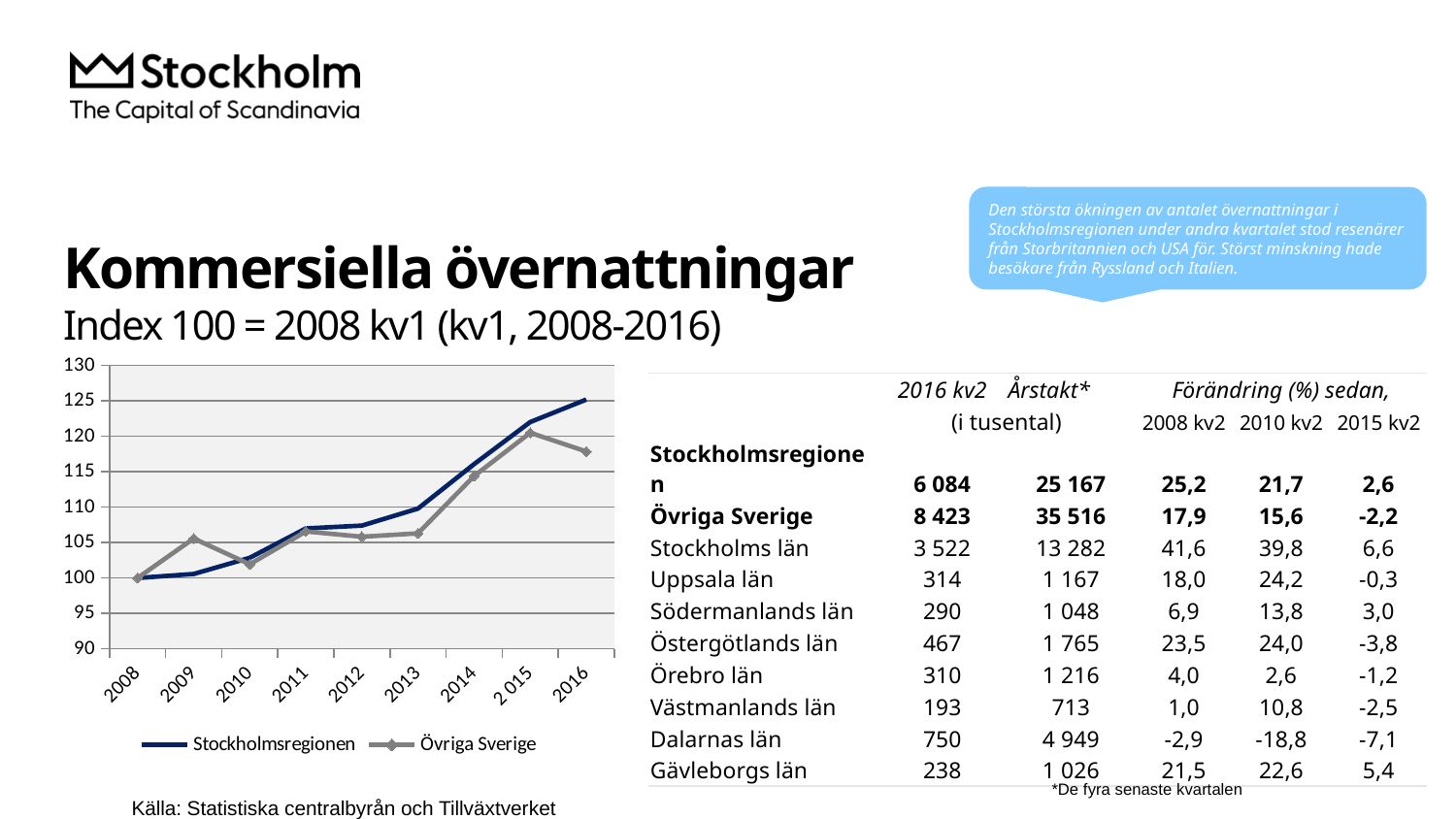
In which year does the Stockholmsregionen series reach its highest value? 2016 Is the value for Övriga Sverige in 2014 greater or less than 110? greater Which series has the higher value in 2016, Stockholmsregionen or Övriga Sverige? Stockholmsregionen Is the value for Övriga Sverige in 2016 greater or less than 120? less What is the index value for Stockholmsregionen in 2008? 100 How many years are plotted along the x axis of the chart? 9 Does the Övriga Sverige series rise or fall between 2015 and 2016? fall What kind of chart is shown on the slide? line chart Is the value for Stockholmsregionen in 2016 greater or less than 120? greater Which series has the higher value in 2009, Stockholmsregionen or Övriga Sverige? Övriga Sverige How many series does the chart legend list? 2 In which year does the Övriga Sverige series reach its highest value? 2015